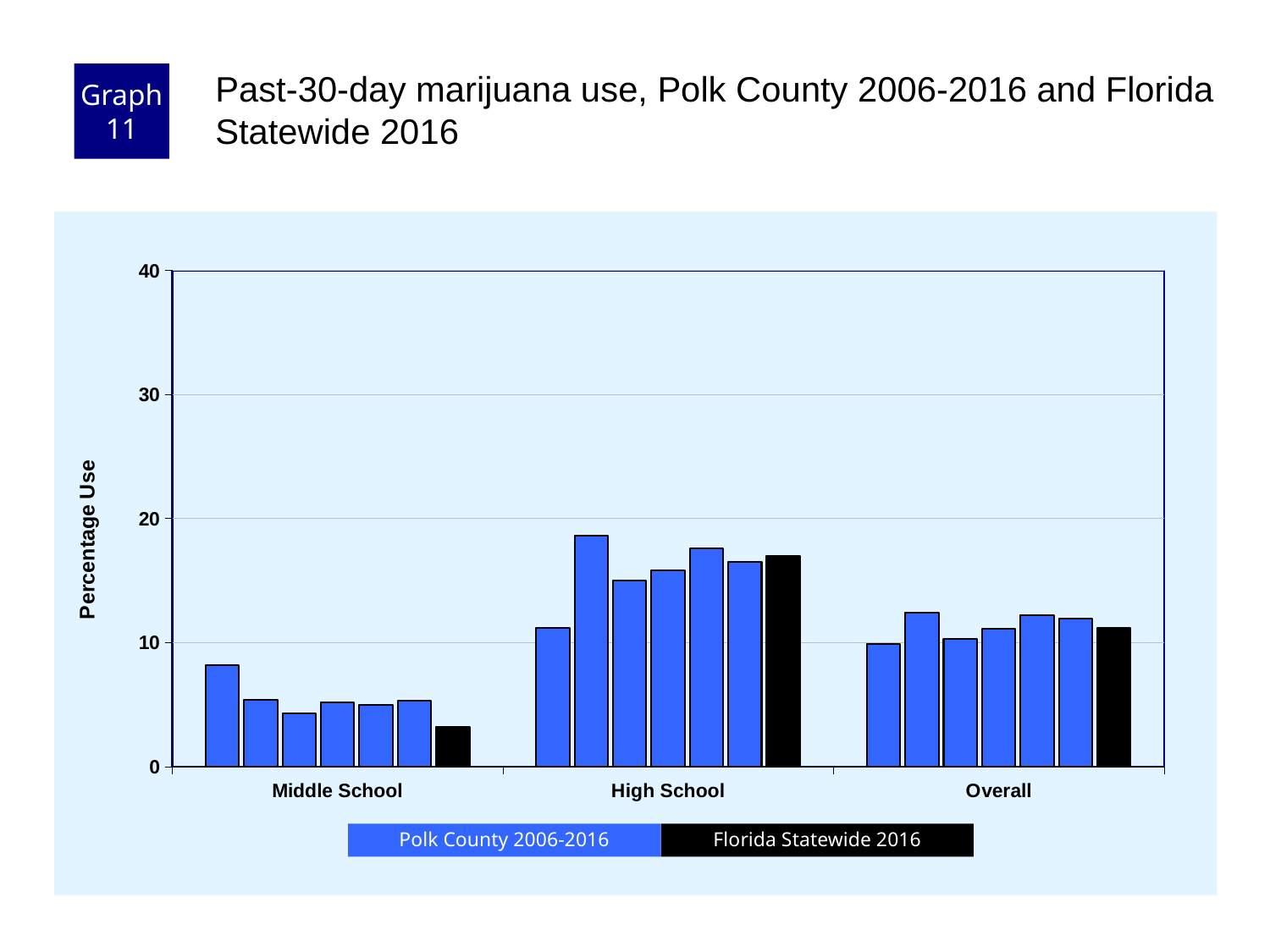
What is the label of the y axis? Percentage Use How many categories are shown on the x axis? 3 Which category has the highest bars overall? High School Is the Florida Statewide 2016 value for High School greater or less than 20? less Is the Florida Statewide 2016 value for High School greater or less than 10? greater Which category has the lowest bars overall? Middle School Are all the Polk County 2006-2016 bars for Middle School greater or less than 10? less How many series does the legend list? 2 Which series is shown in black in the legend? Florida Statewide 2016 Which is larger, the Florida Statewide 2016 value for High School or for Overall? High School What kind of chart is shown on the slide? Bar chart